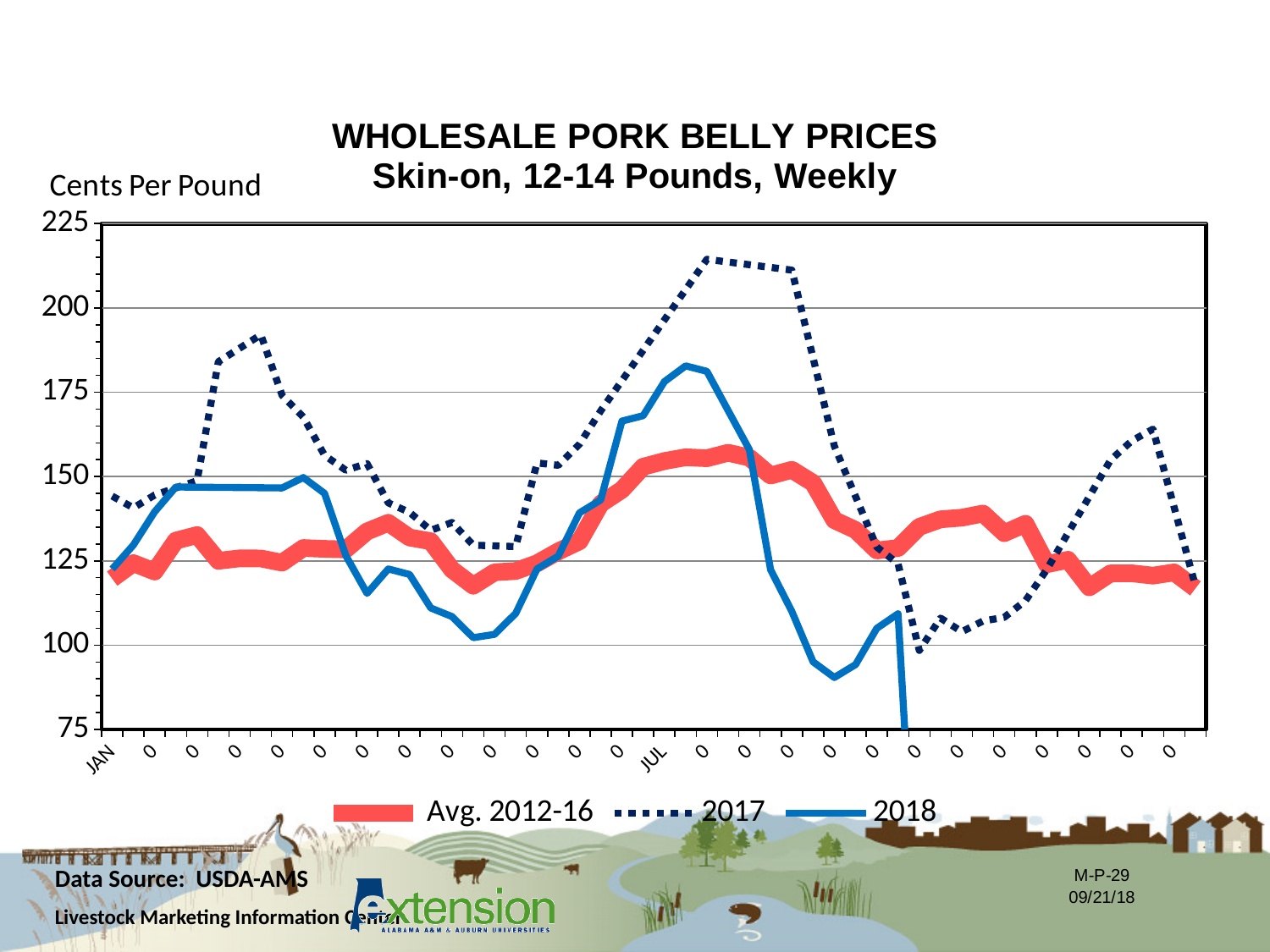
Between JAN and JUL, does the 2018 line overall rise or fall? rise Is the peak value of the Avg. 2012-16 line greater or less than 150? greater Which series reaches the highest value on the chart? 2017 Is the early-spring peak of the 2017 line (before JUL) greater or less than 175? greater Is the peak value of the 2017 line greater or less than 200? greater What unit is shown for the vertical axis? Cents Per Pound What type of chart is shown on the slide? line chart How many series does the legend list? 3 At JUL, which is higher, the 2017 line or the 2018 line? 2017 What are the three series named in the legend? Avg. 2012-16, 2017, 2018 Which series dips to the lowest value shown on the chart? 2018